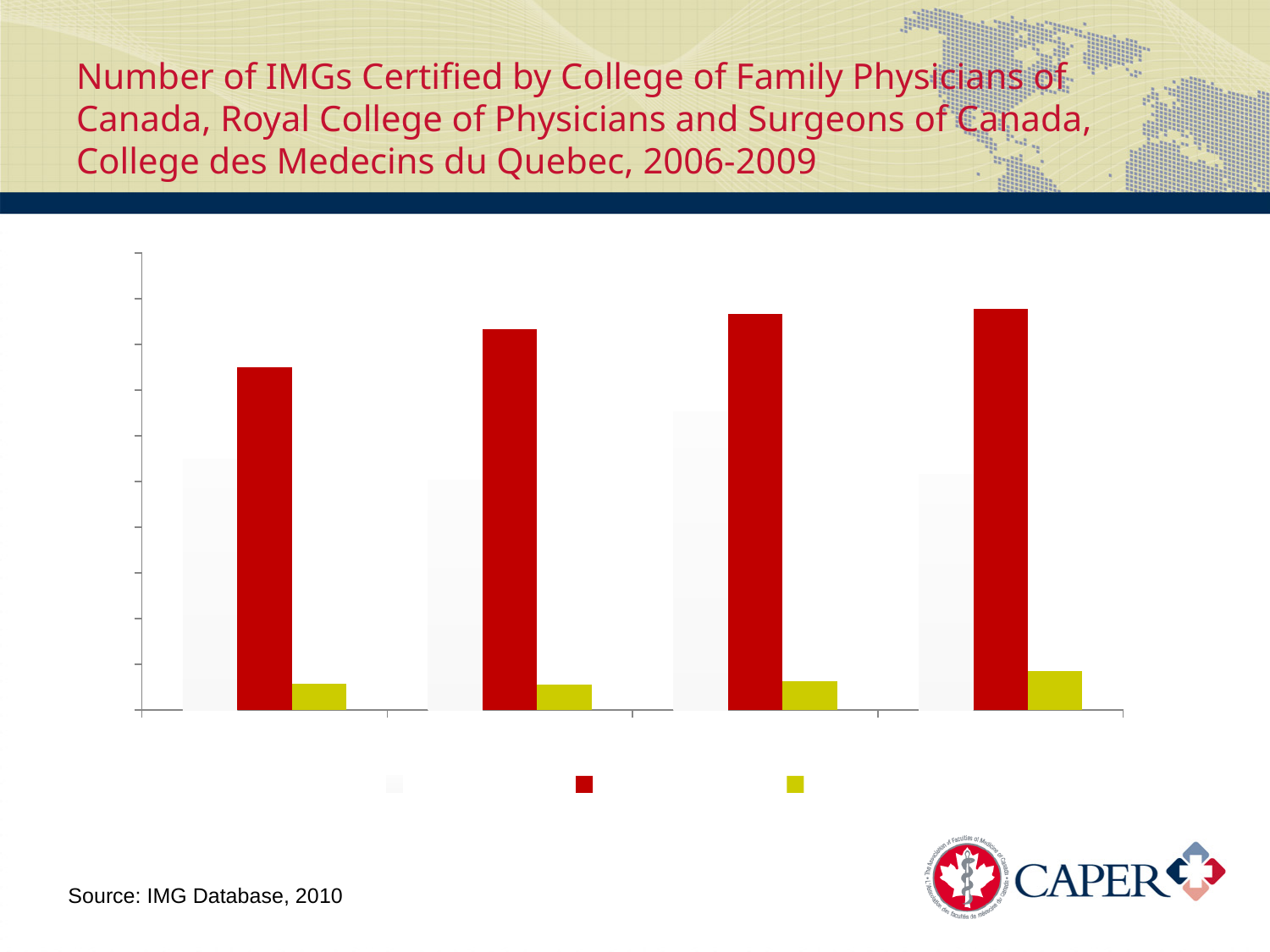
Which colour of bar is the tallest in every group? red How many groups of bars are plotted along the x axis? 4 What source is cited at the bottom of the slide? IMG Database, 2010 Do the red bars rise or fall from left to right across the groups? rise How many series does the legend show? 3 What kind of chart is shown on the slide? bar chart Which colour of bar is the shortest in every group? yellow Which group from the left has the shortest red bar? the first What years does the slide title say the chart covers? 2006-2009 Which group from the left has the tallest red bar? the fourth In the fourth group from the left, is the yellow bar or the light grey bar taller? light grey In the first group from the left, is the red bar or the light grey bar taller? red